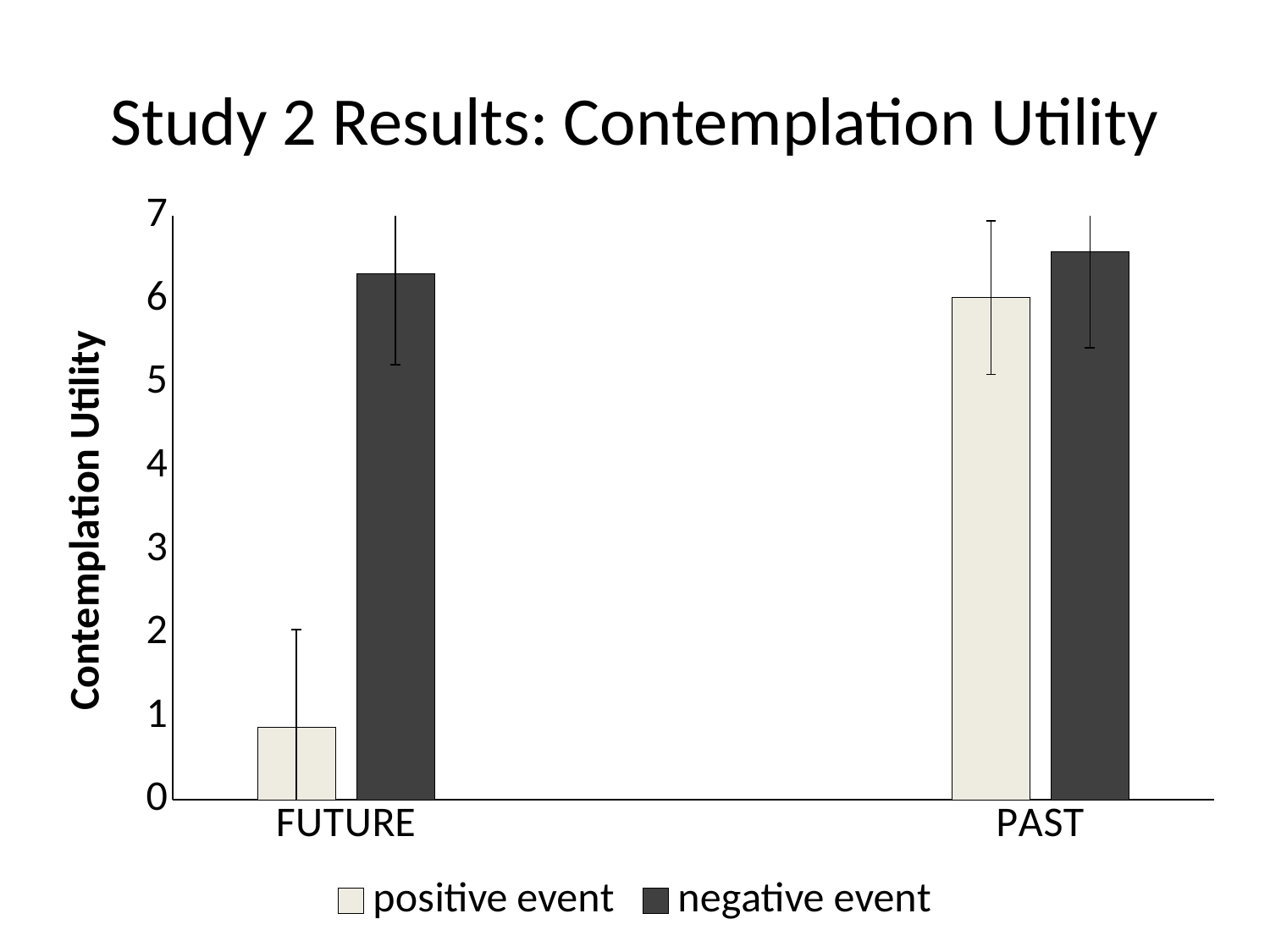
Is the value for the positive event in the FUTURE category greater or less than 2? less How many categories are shown on the x axis? 2 Is the value for the positive event in the PAST category greater or less than 5? greater Is the value for the negative event in the PAST category greater or less than 6? greater What kind of chart is shown on the slide? bar chart For FUTURE, which is larger: the positive event bar or the negative event bar? negative event What is the title of the chart? Study 2 Results: Contemplation Utility Which category and series combination has the lowest contemplation utility? FUTURE, positive event What is the label on the y axis? Contemplation Utility Does the positive event series rise or fall from FUTURE to PAST? rise How many series does the legend list? 2